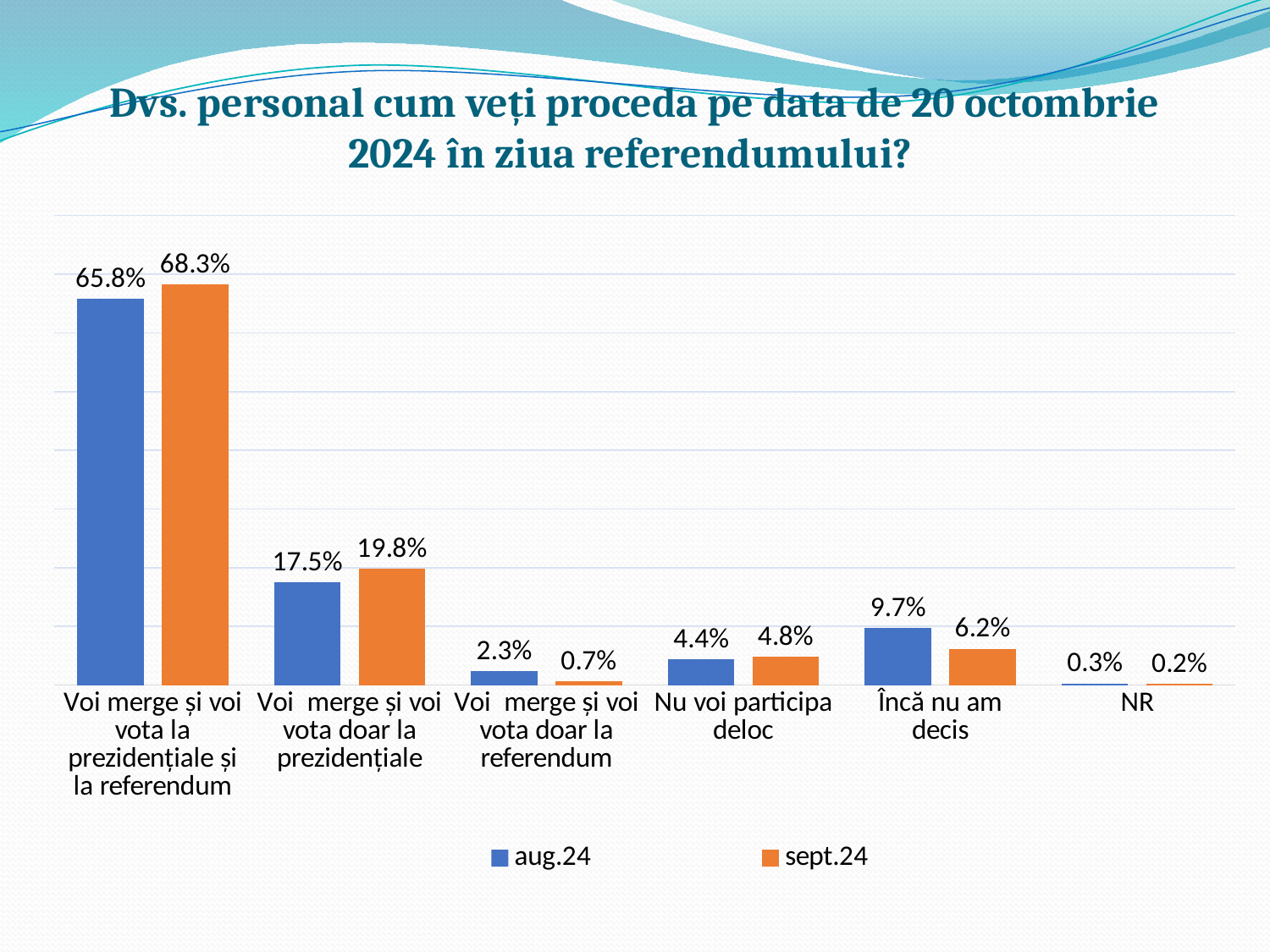
Which category has the lowest aug.24 value? NR Which series is shown in orange? sept.24 How many series does the legend list? 2 What is the aug.24 value for "Voi merge și voi vota doar la referendum"? 2.3% What kind of chart is shown on the slide? Bar chart What is the sept.24 value for "Voi merge și voi vota la prezidențiale și la referendum"? 68.3% Which category has the highest sept.24 value? Voi merge și voi vota la prezidențiale și la referendum Which is larger for "Încă nu am decis": the aug.24 value or the sept.24 value? aug.24 Which is larger for "Nu voi participa deloc": the aug.24 value or the sept.24 value? sept.24 How many categories are shown on the x axis? 6 What is the difference between the sept.24 and aug.24 values for "Voi merge și voi vota doar la prezidențiale"? 2.3% What is the aug.24 value for "Încă nu am decis"? 9.7%